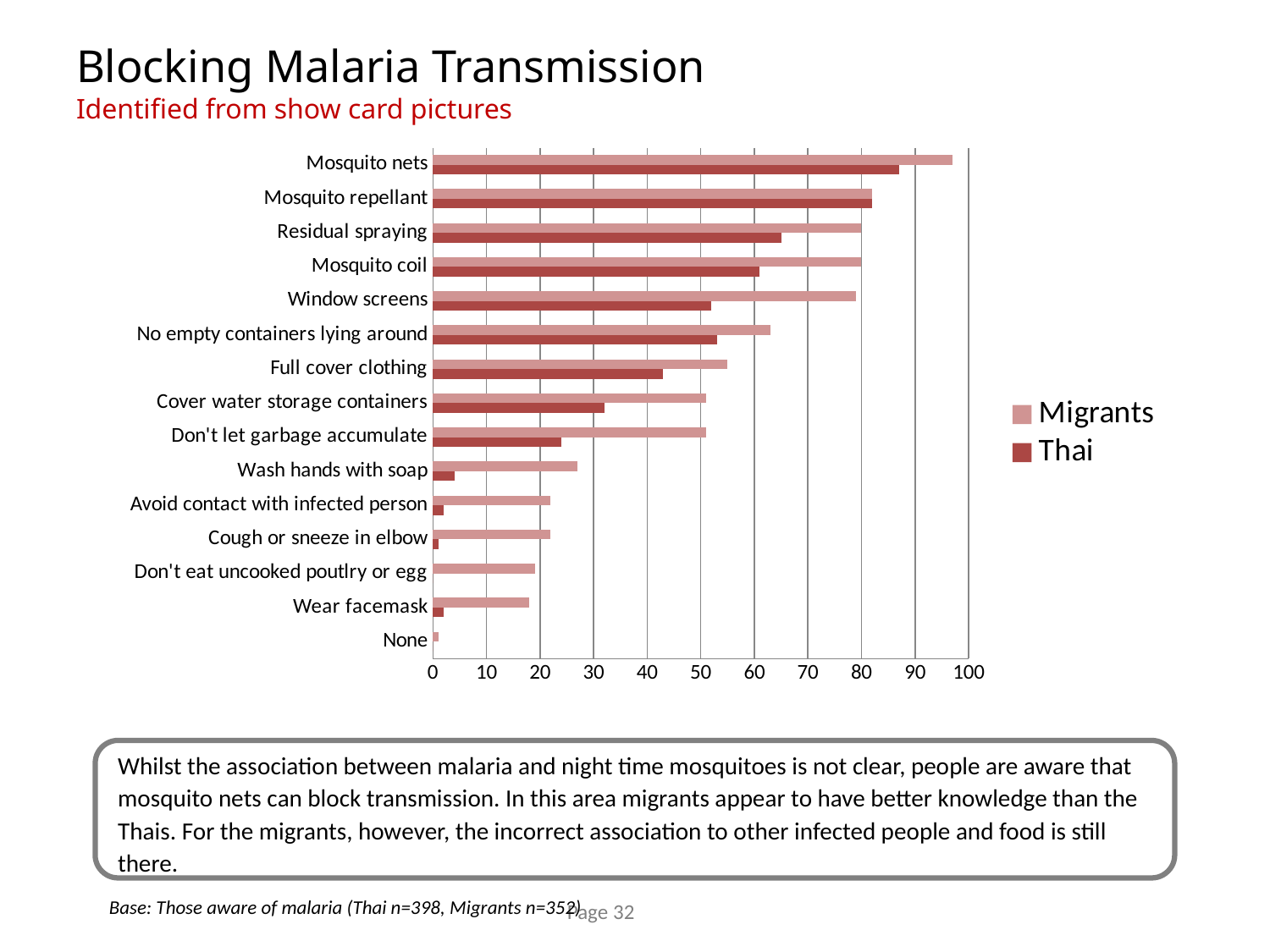
For Cover water storage containers, which is larger: the Migrants value or the Thai value? Migrants Is the Thai value for Wash hands with soap greater or less than 10? less Is the Thai value for Full cover clothing greater or less than 50? less How many categories are plotted on the chart? 15 Is the Migrants value for Mosquito nets greater or less than 90? greater How many series does the legend list? 2 Which category has the lowest value for Migrants? None What kind of chart is shown on the slide? bar chart What are the two series named in the legend? Migrants and Thai Which category has the highest value for Thai? Mosquito nets Which category has the highest value for Migrants? Mosquito nets